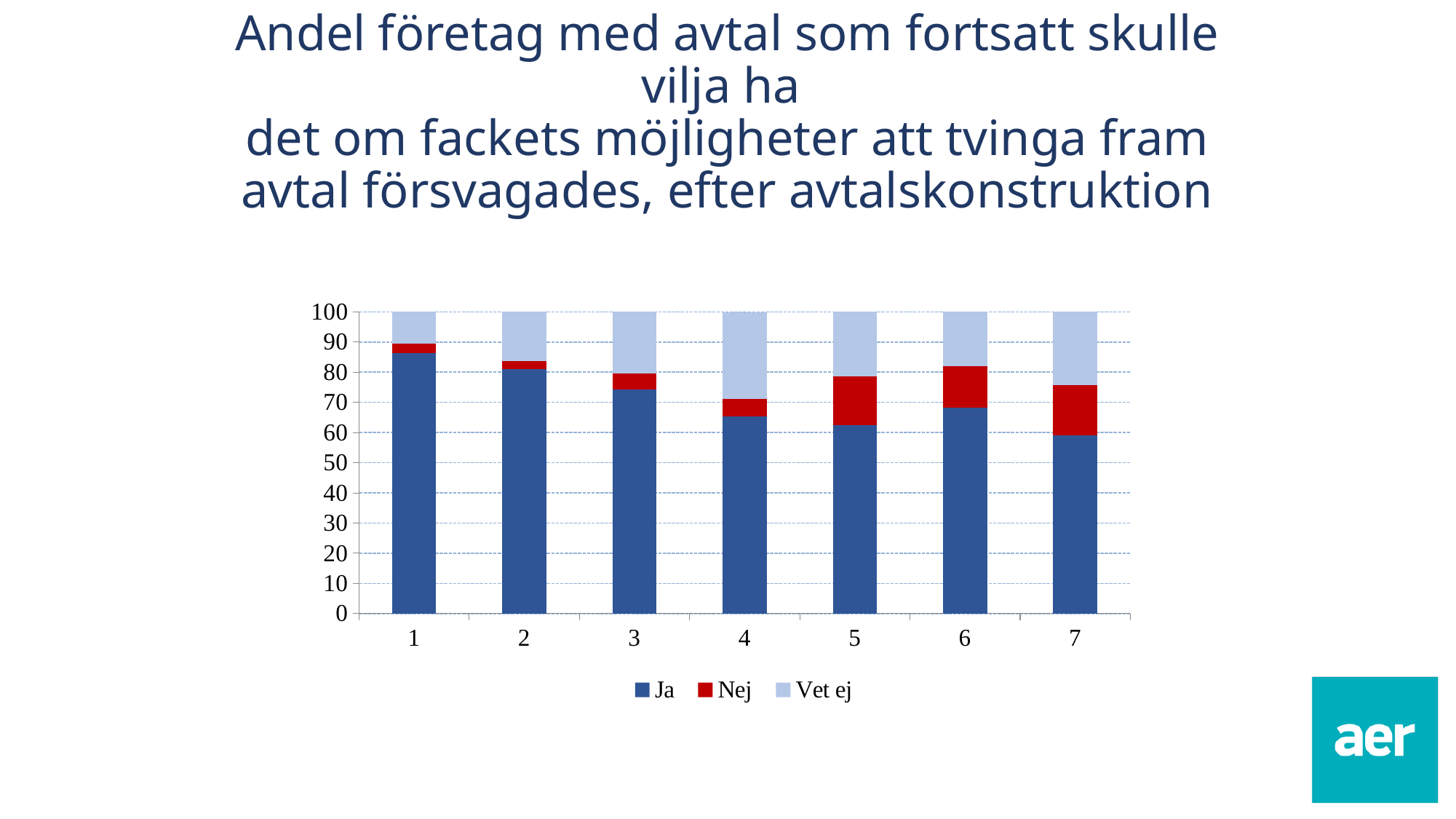
How many series does the legend list? 3 What is the total of the stacked bar for category 3? 100 Which category has the lowest value for Ja? 7 Which is larger, the Ja value for category 2 or for category 6? category 2 Which category has the highest value for Ja? 1 How many categories are shown on the x axis? 7 Is the value for Ja in category 1 greater or less than 80? greater Which category has the smallest Vet ej segment? 1 Is the value for Ja in category 5 greater or less than 70? less What are the series names listed in the legend? Ja, Nej, Vet ej What kind of chart is shown on the slide? stacked bar chart Which category has the largest Vet ej segment? 4